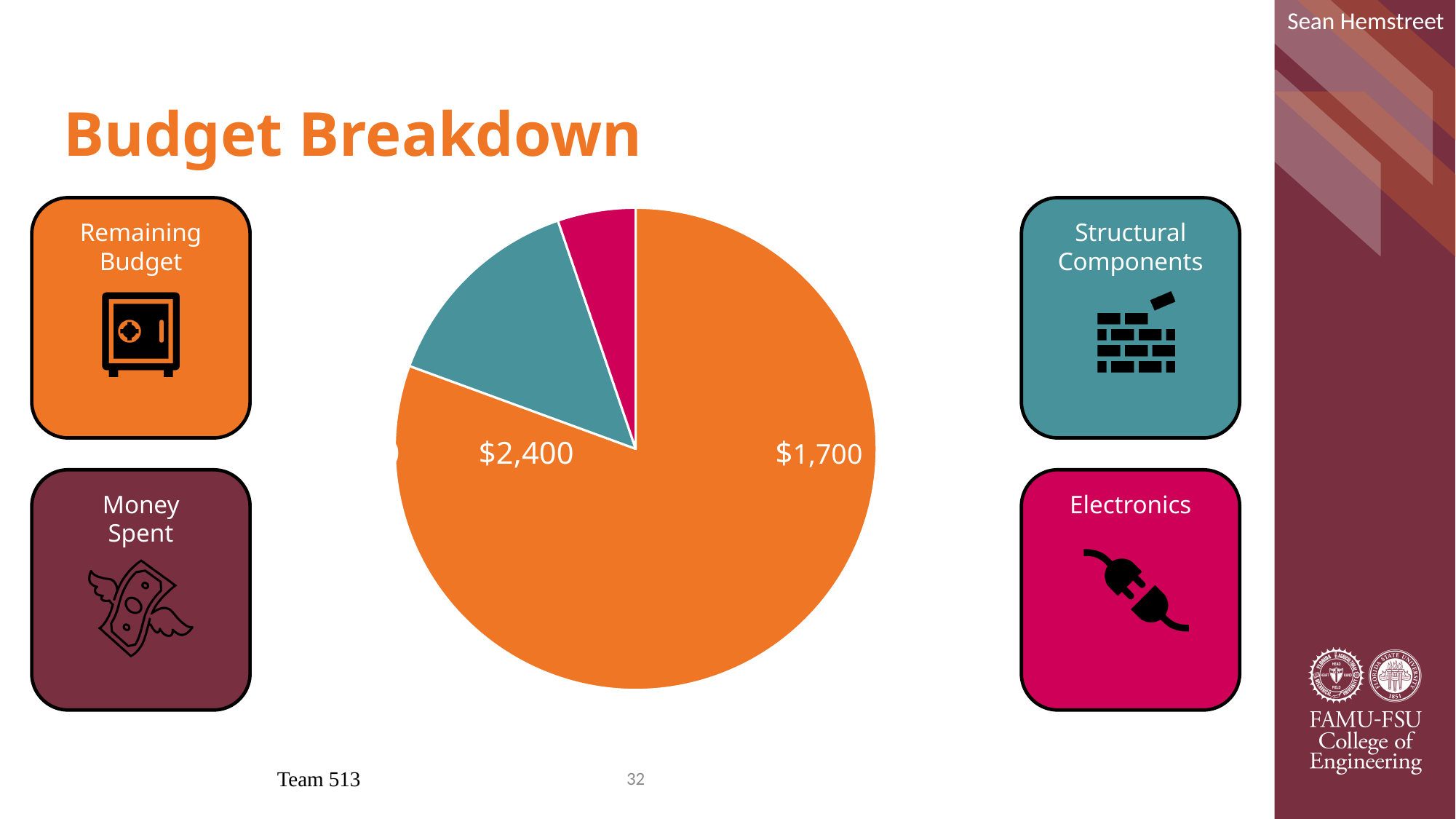
Which slice is larger, Remaining Budget or Structural Components? Remaining Budget What colour is the largest slice of the pie chart? orange Which category has the smallest slice of the pie chart? Electronics What kind of chart is shown on the slide? pie chart Which category has the largest slice of the pie chart? Remaining Budget Does the Remaining Budget slice take up more or less than half of the pie? more What is the title of the slide containing the pie chart? Budget Breakdown Which slice is larger, Structural Components or Electronics? Structural Components How many slices does the pie chart have? 3